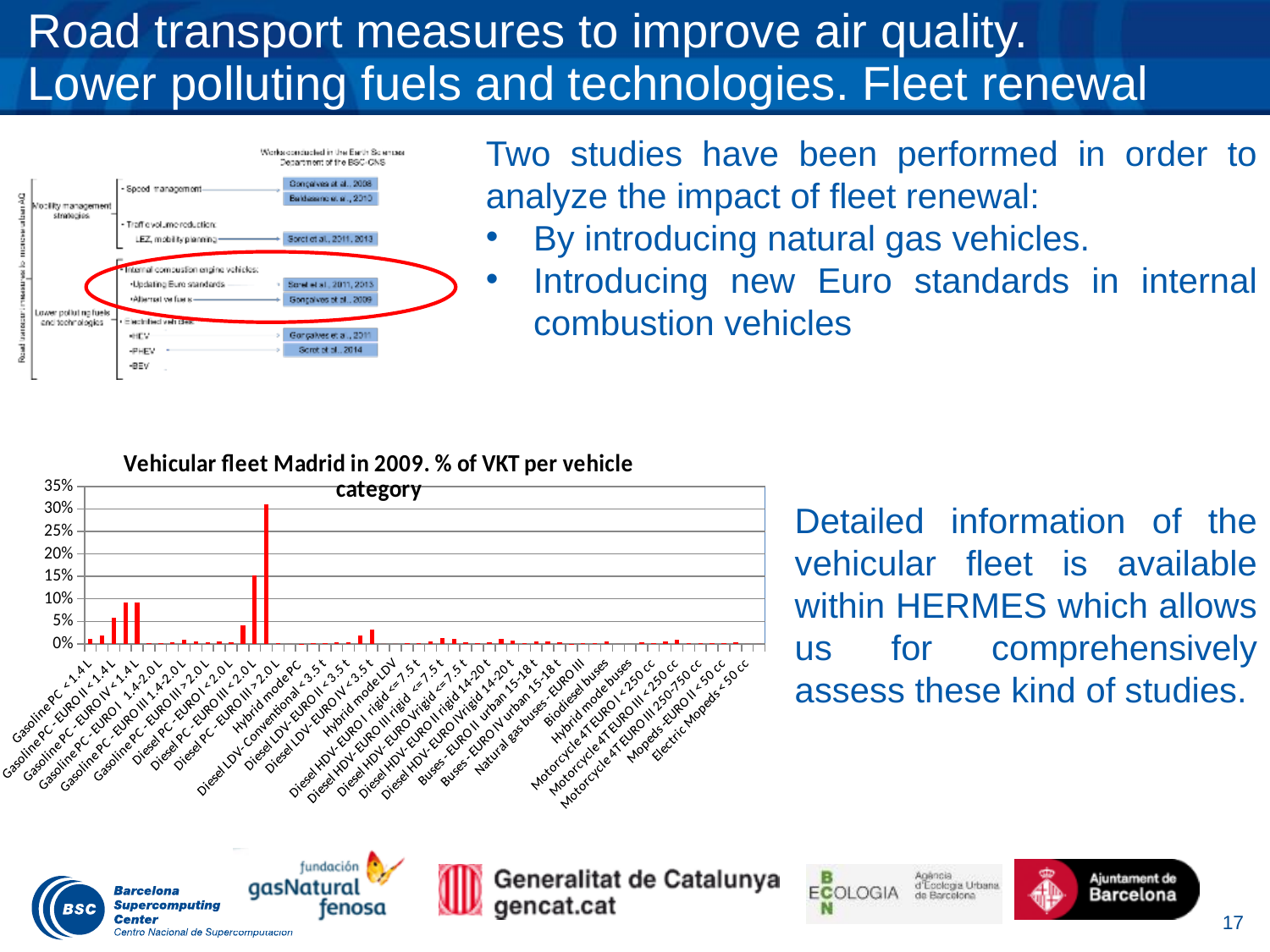
Is the value for 'Electric Mopeds < 50 cc' greater or less than 5%? less Is the value for 'Hybrid mode PC' greater or less than 5%? less How many bars in the chart exceed 20%? 1 Is the value for 'Biodiesel buses' greater or less than 5%? less What kind of chart is shown under the heading 'Vehicular fleet Madrid in 2009'? bar chart What is the title of the chart on the slide? Vehicular fleet Madrid in 2009. % of VKT per vehicle category What is the highest tick value shown on the y axis of the chart? 35%